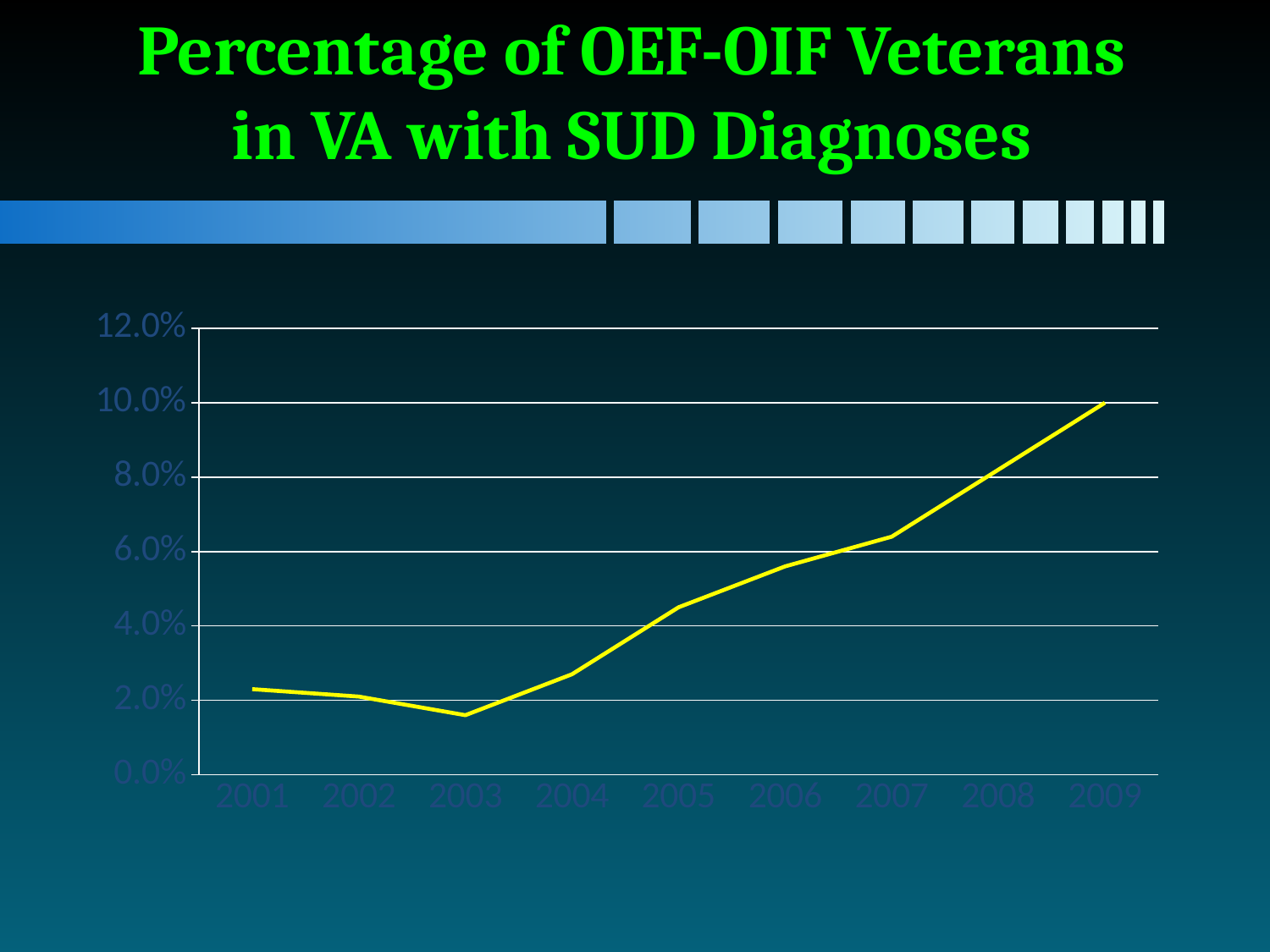
What is the title of the slide containing the chart? Percentage of OEF-OIF Veterans in VA with SUD Diagnoses Which year has the lowest percentage of OEF-OIF veterans with SUD diagnoses? 2003 Is the value for 2003 greater or less than 2.0%? less How many years are plotted along the x axis? 9 Is the value for 2006 greater or less than 6.0%? less What kind of chart is shown on the slide? line chart Which year has the larger value, 2001 or 2009? 2009 Is the value for 2007 greater or less than 6.0%? greater Do the values generally rise or fall from 2003 to 2009? rise Which year has the highest percentage of OEF-OIF veterans with SUD diagnoses? 2009